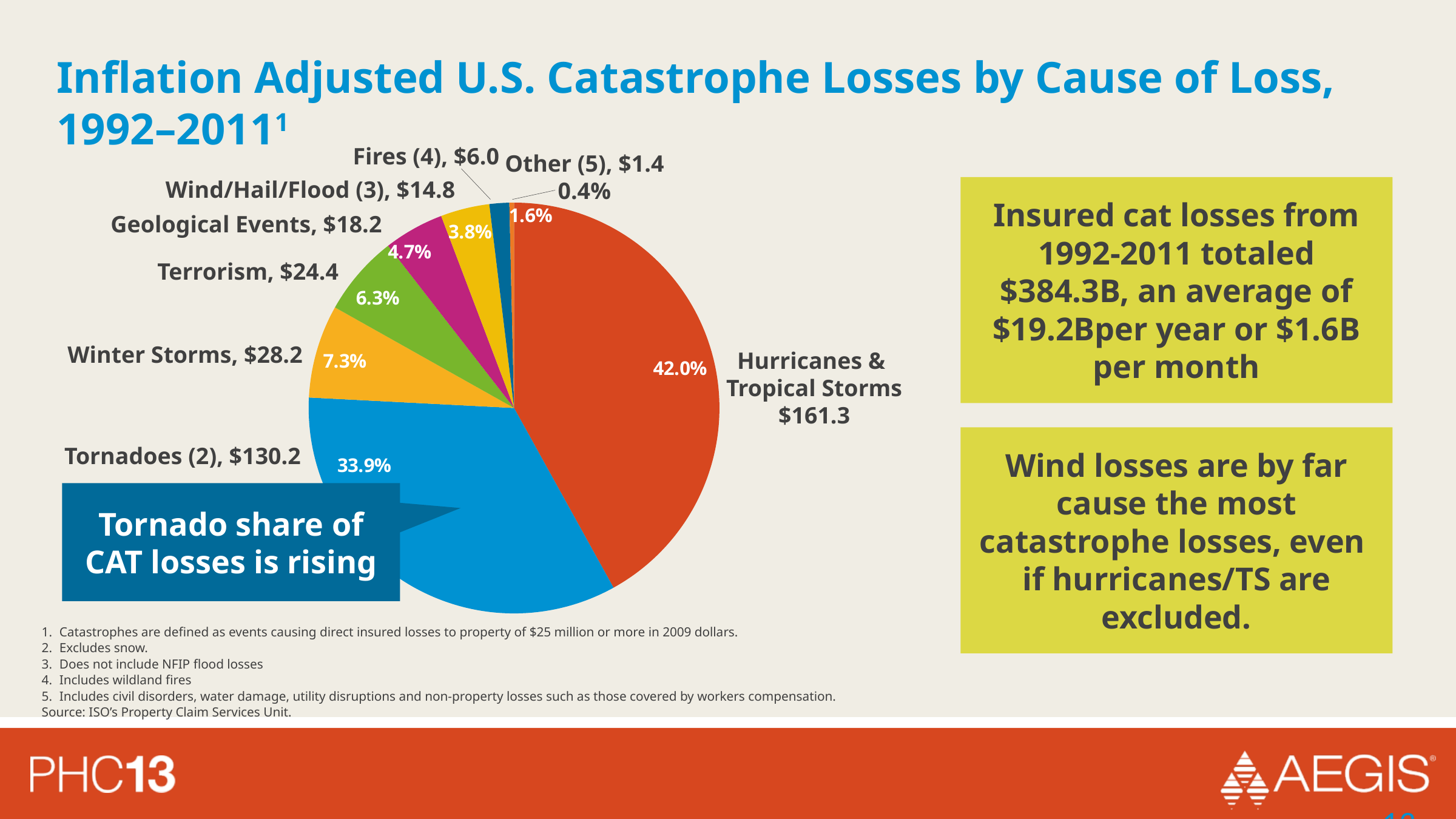
Which is larger, the value for Winter Storms or the value for Terrorism? Winter Storms How many categories (slices) does the pie chart show? 8 What share of the pie does Tornadoes (2) represent? 33.9% What is the value shown for Hurricanes & Tropical Storms? $161.3 Which category has the smallest share of catastrophe losses? Other (5) What type of chart is shown on the slide? Pie chart What is the value shown for Tornadoes (2)? $130.2 What is the value shown for Terrorism? $24.4 What is the difference between the Hurricanes & Tropical Storms value and the Tornadoes (2) value? $31.1 Which category has the largest share of catastrophe losses? Hurricanes & Tropical Storms What share of the pie does Geological Events represent? 4.7% What is the value shown for Winter Storms? $28.2